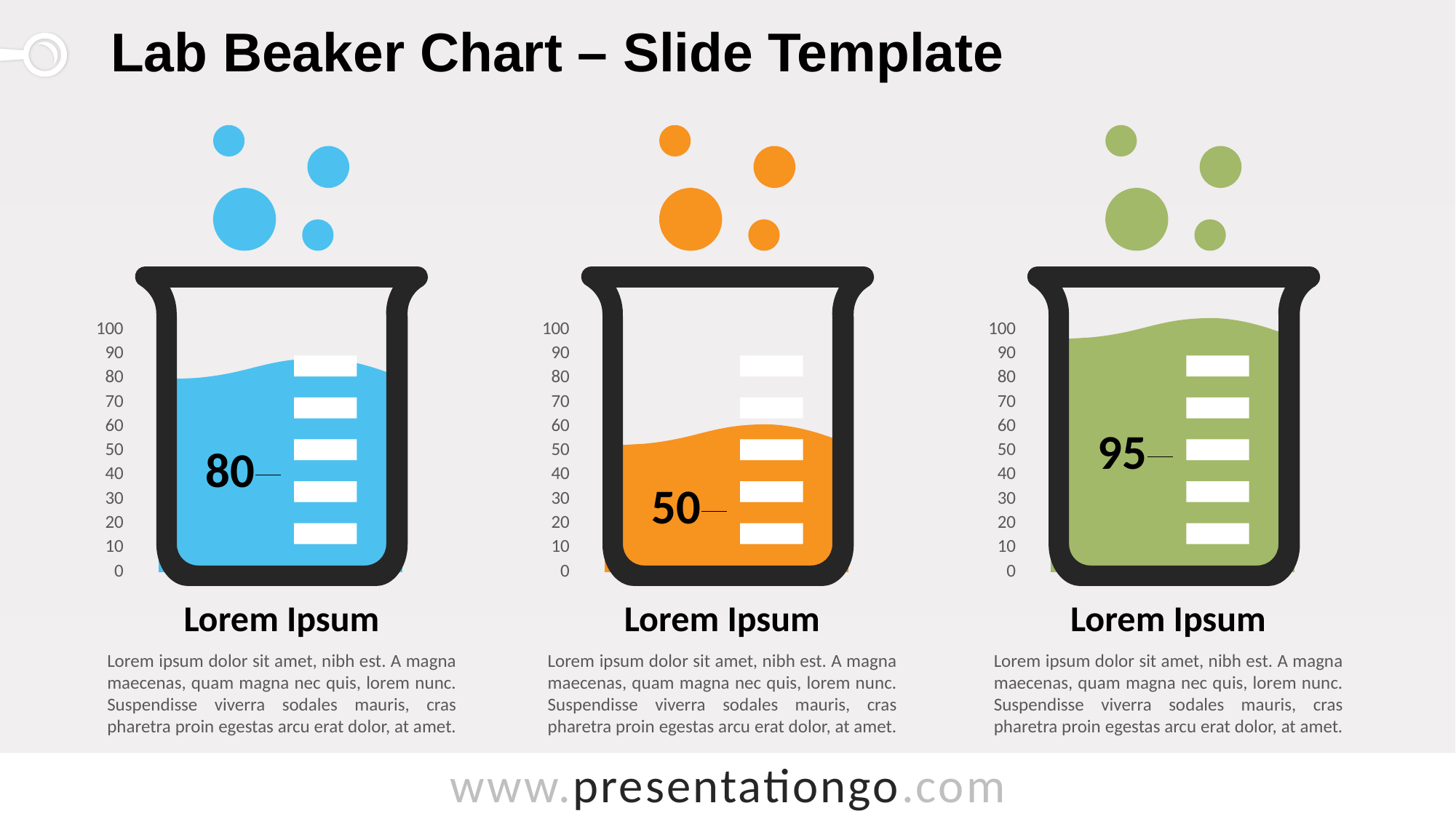
What value is shown in the left (blue) beaker chart? 80 Which is larger, the value in the left beaker chart or the value in the middle beaker chart? left What is the difference between the value in the left beaker chart and the value in the middle beaker chart? 30 Which beaker chart shows the lowest value: left, middle or right? middle What value is shown in the middle (orange) beaker chart? 50 Is the value in the middle (orange) beaker chart greater or less than 60? less What value is shown in the right (green) beaker chart? 95 What colour is the fill of the middle beaker chart? orange What is the difference between the value in the right beaker chart and the value in the middle beaker chart? 45 Which beaker chart shows the highest value: left, middle or right? right What is the maximum value shown on the axis of each beaker chart? 100 How many beaker charts are shown on the slide? 3